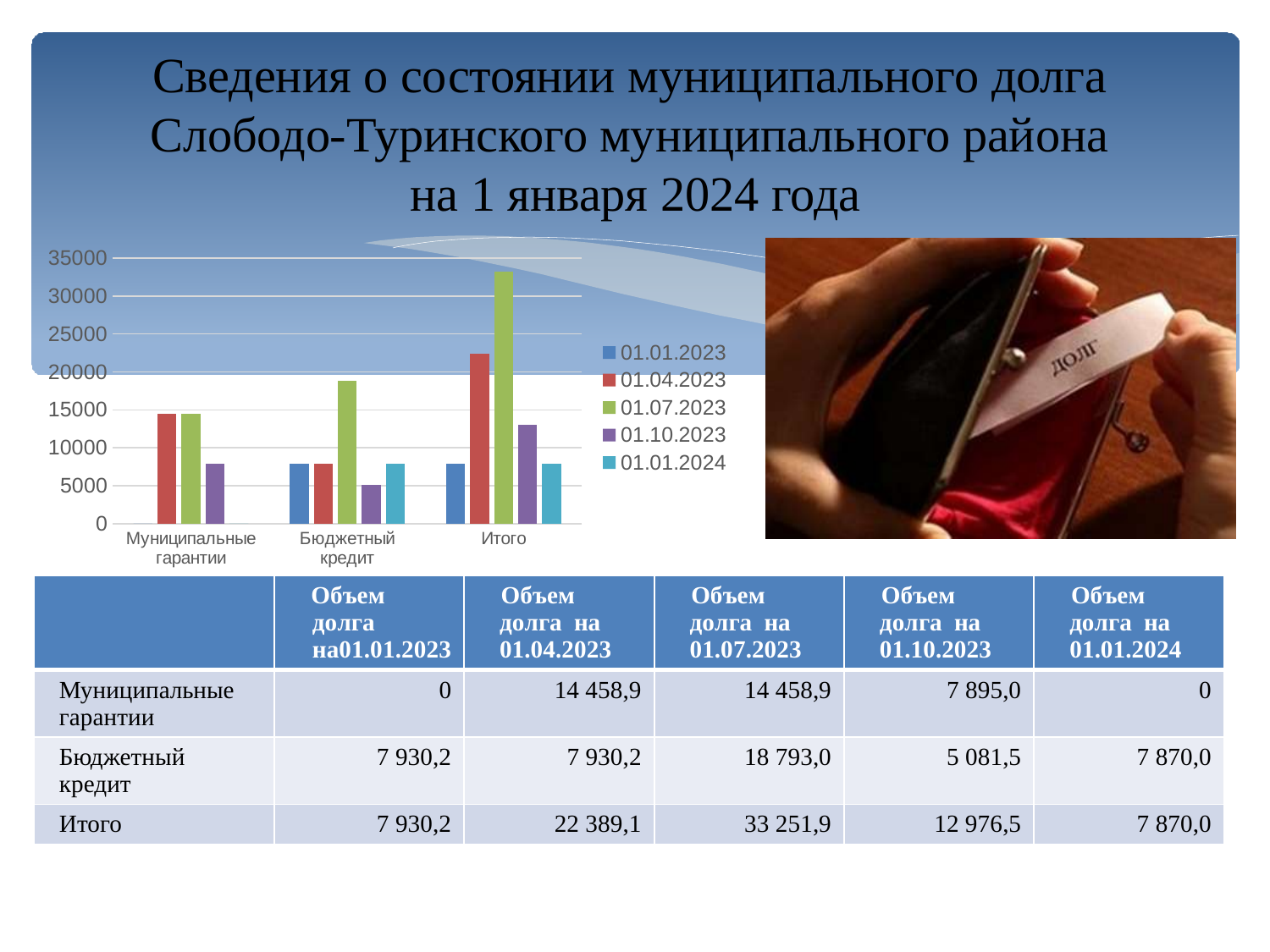
For the category Итого, which series has the highest bar? 01.07.2023 What is the value of Итого on 01.07.2023? 33 251,9 Is the value for Бюджетный кредит on 01.07.2023 greater or less than 15000? greater What is the difference between Итого on 01.07.2023 and Итого on 01.10.2023? 20 275,4 What is the first entry in the chart legend? 01.01.2023 How many series does the chart legend list? 5 What kind of chart is shown on the slide? bar chart On 01.04.2023, which is larger: Муниципальные гарантии or Бюджетный кредит? Муниципальные гарантии Is the value for Муниципальные гарантии on 01.10.2023 greater or less than 10000? less What is the value of Бюджетный кредит on 01.10.2023? 5 081,5 For the category Бюджетный кредит, which series has the lowest bar? 01.10.2023 How many categories are shown on the x axis of the chart? 3